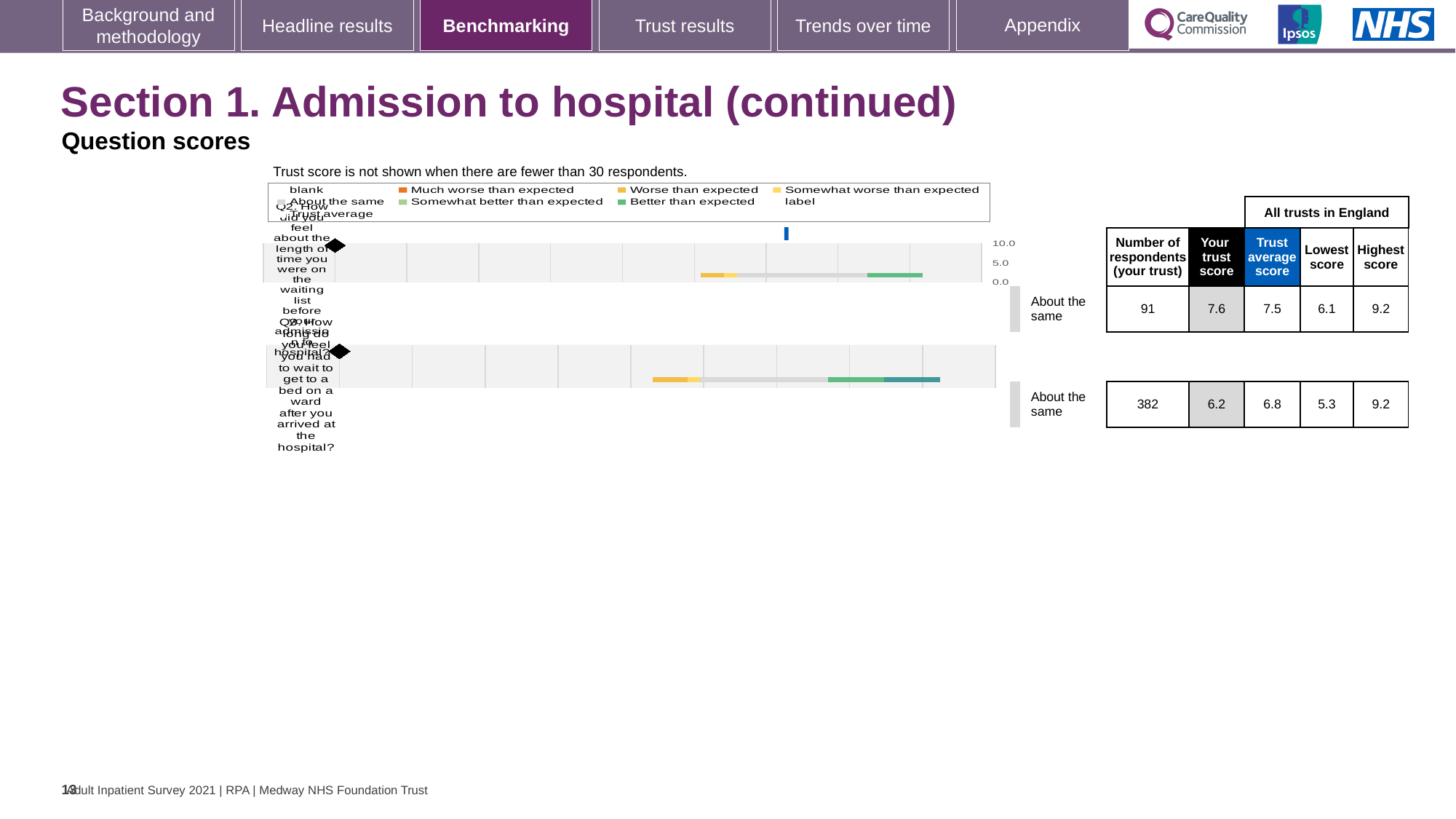
What benchmark rating is shown next to the Q2 chart? About the same What is the difference between the trust score for Q2 and the trust score for Q3? 1.4 How many questions (Q2 and Q3) are plotted in the benchmarking chart? 2 How many respondents answered Q3 for this trust? 382 What is the highest value shown on the score axis of the chart? 10.0 What is the trust average score for Q2? 7.5 Which question has the higher trust score, Q2 or Q3? Q2 What is the trust score for Q3 (how long you had to wait to get to a bed on a ward)? 6.2 What kind of chart is used to show the question scores on this slide? bar chart What is the highest score across all trusts in England for Q3? 9.2 What is the trust score for Q2 (length of time on the waiting list before admission)? 7.6 Is the trust score for Q3 greater or less than 5.0 on the chart axis? greater